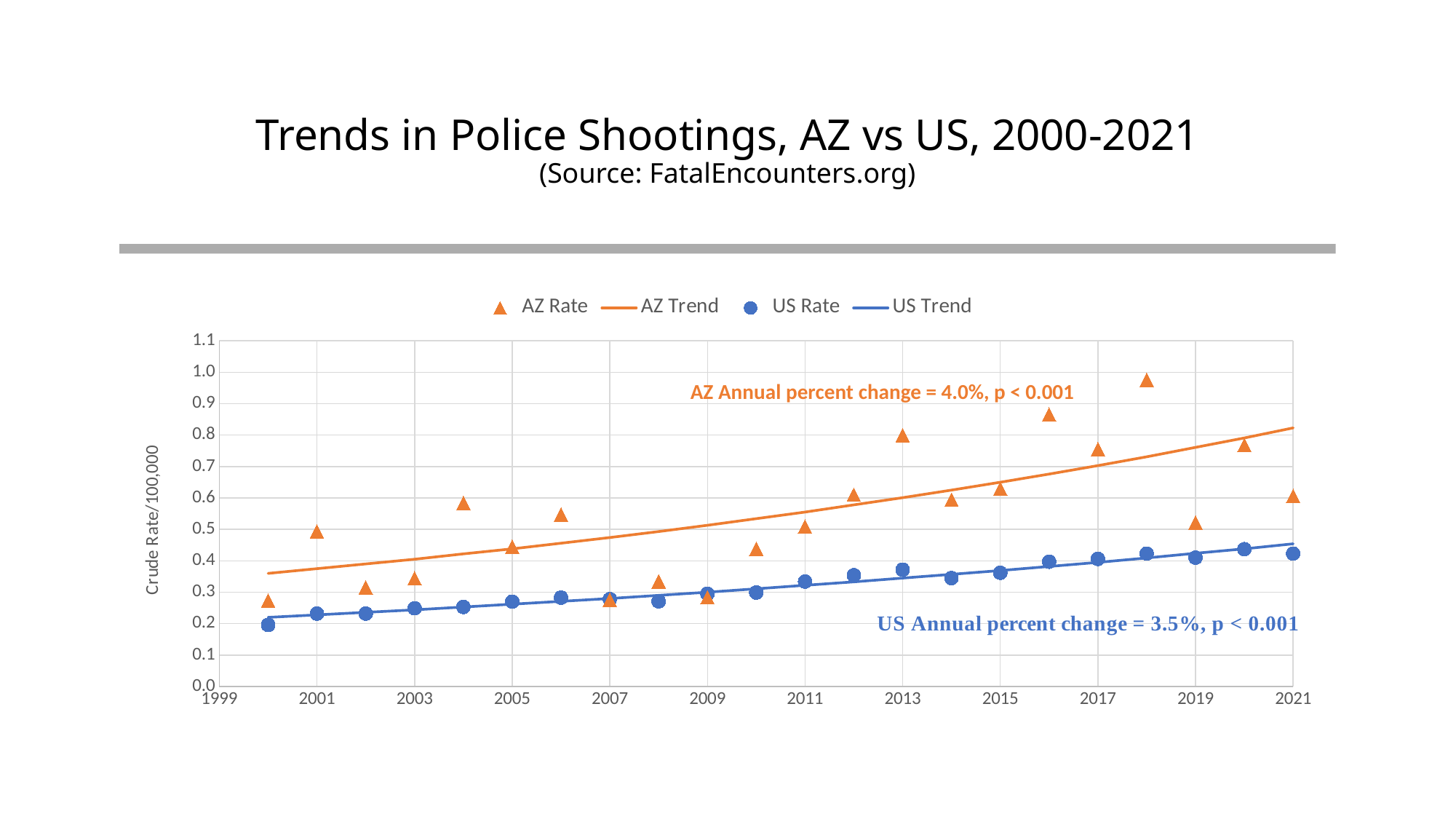
Is the AZ Rate for 2004 greater or less than 0.5? greater In which year is the US Rate lowest? 2000 Which is larger in 2018, the AZ Rate or the US Rate? AZ Rate In which year is the AZ Rate highest? 2018 Is the US Rate for 2021 greater or less than 0.4? greater Does the US Rate generally rise or fall from 2000 to 2021? Rise Is the AZ Rate for 2018 greater or less than 0.9? greater What is the AZ annual percent change stated on the chart? 4.0% What is the US annual percent change stated on the chart? 3.5% How many series does the legend list? 4 What kind of chart is shown on the slide? Scatter plot with trend lines